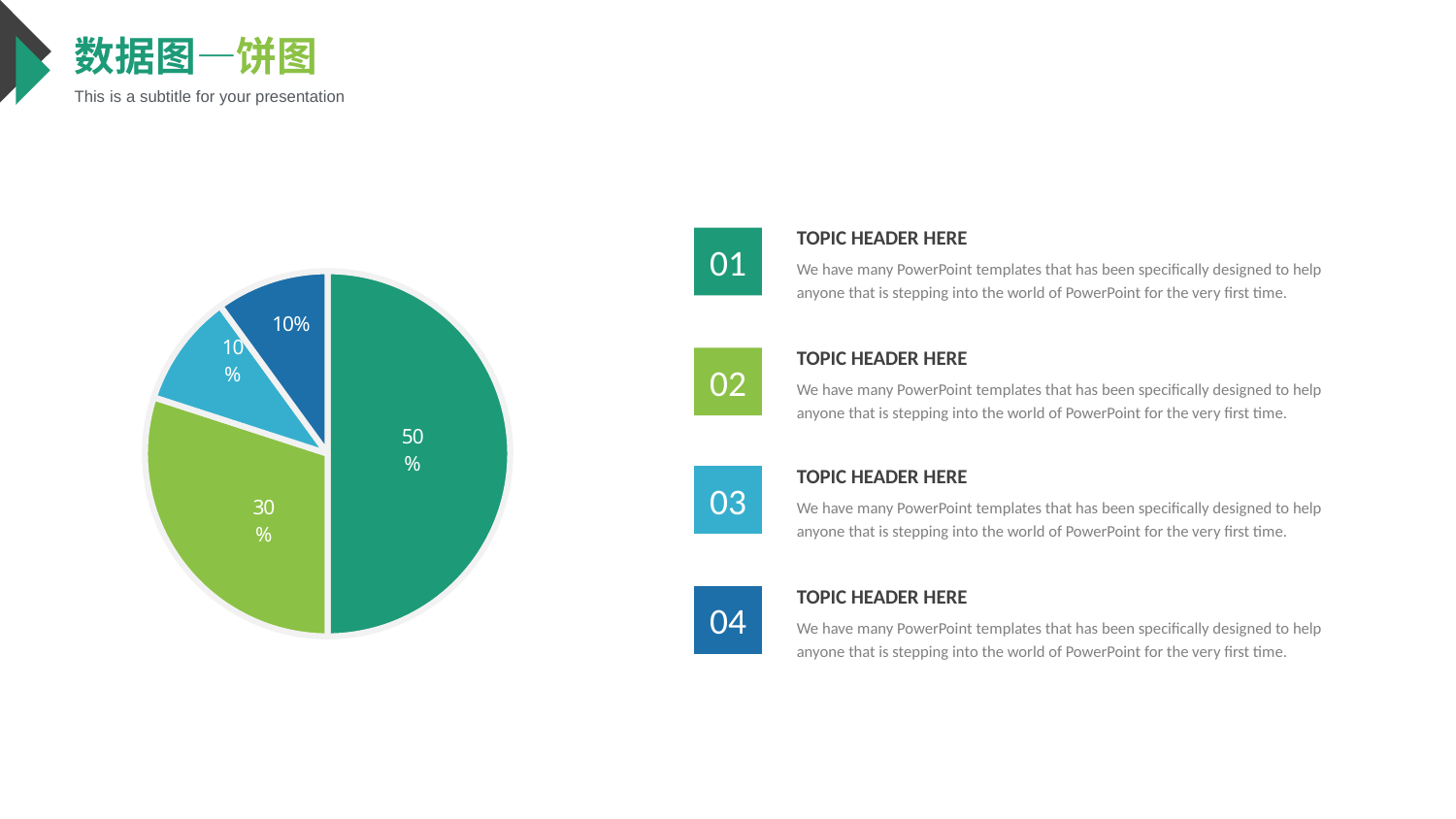
What is the difference between the largest slice (50%) and the light green slice (30%) in the pie chart? 20% How many slices does the pie chart have? 4 What is the combined share of the two 10% slices in the pie chart? 20% How many slices in the pie chart are labelled 10%? 2 What is the smallest percentage shown on any slice of the pie chart? 10% Does the pie chart have a legend? No What percentage is shown on the light green slice of the pie chart? 30% What percentage is shown on the largest slice of the pie chart? 50% What percentage is shown on the light blue slice of the pie chart? 10% What percentage is shown on the dark blue slice of the pie chart? 10% Which slice is larger in the pie chart, the teal slice or the light green slice? the teal slice What kind of chart is shown on the slide? pie chart